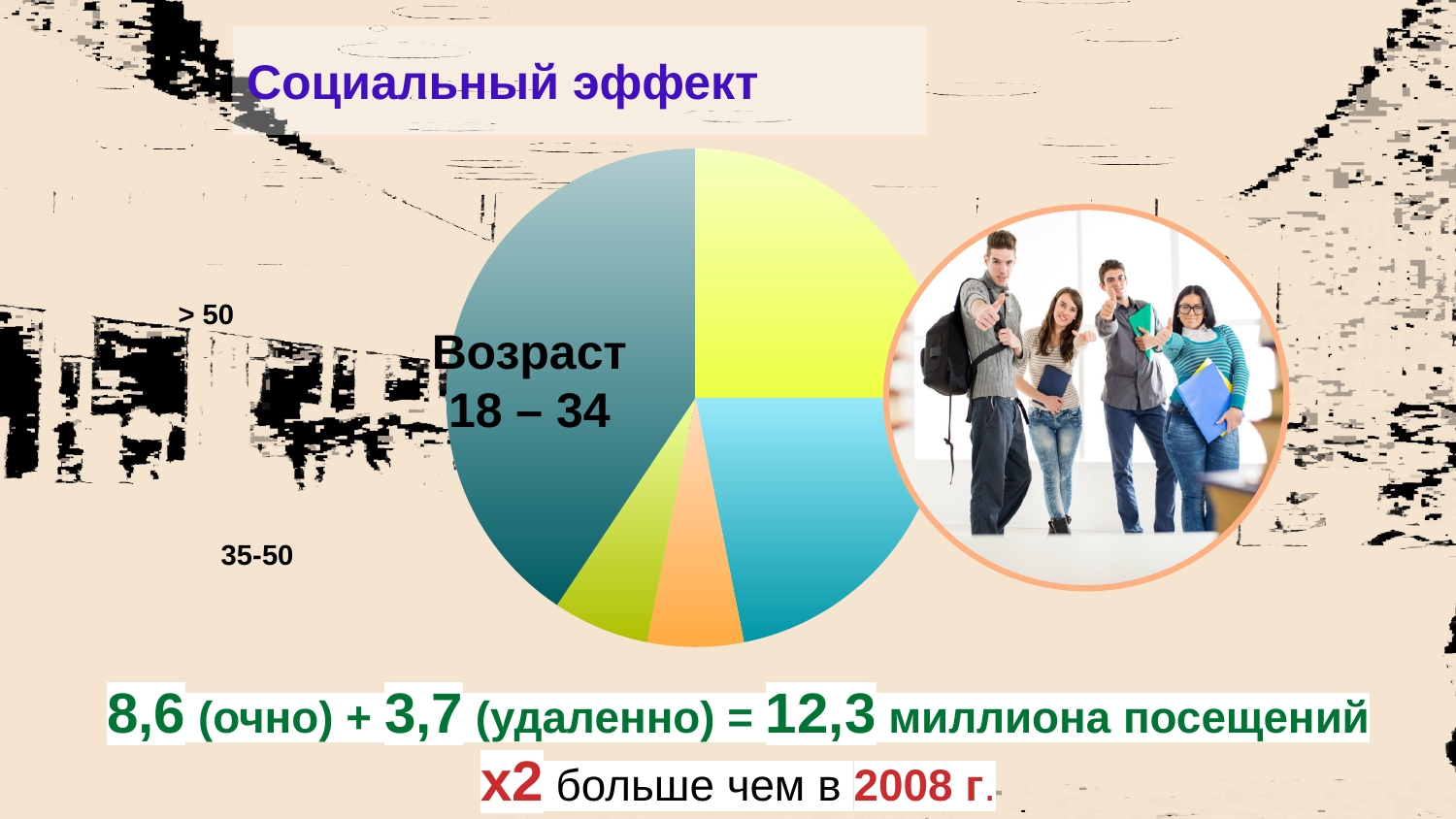
Which is larger in the pie chart: the cyan slice or the lime-green slice? the cyan slice How many slices does the pie chart have? 5 What kind of chart is shown on the slide? pie chart Which is larger in the pie chart: the yellow-green slice or the orange slice? the yellow-green slice What label is printed inside the largest slice of the pie chart? Возраст 18 – 34 Which is larger in the pie chart: the teal slice (Возраст 18 – 34) or the cyan slice? the teal slice (Возраст 18 – 34) What is the title shown at the top of the slide above the pie chart? Социальный эффект Which slice of the pie chart is the largest? the teal slice labelled Возраст 18 – 34